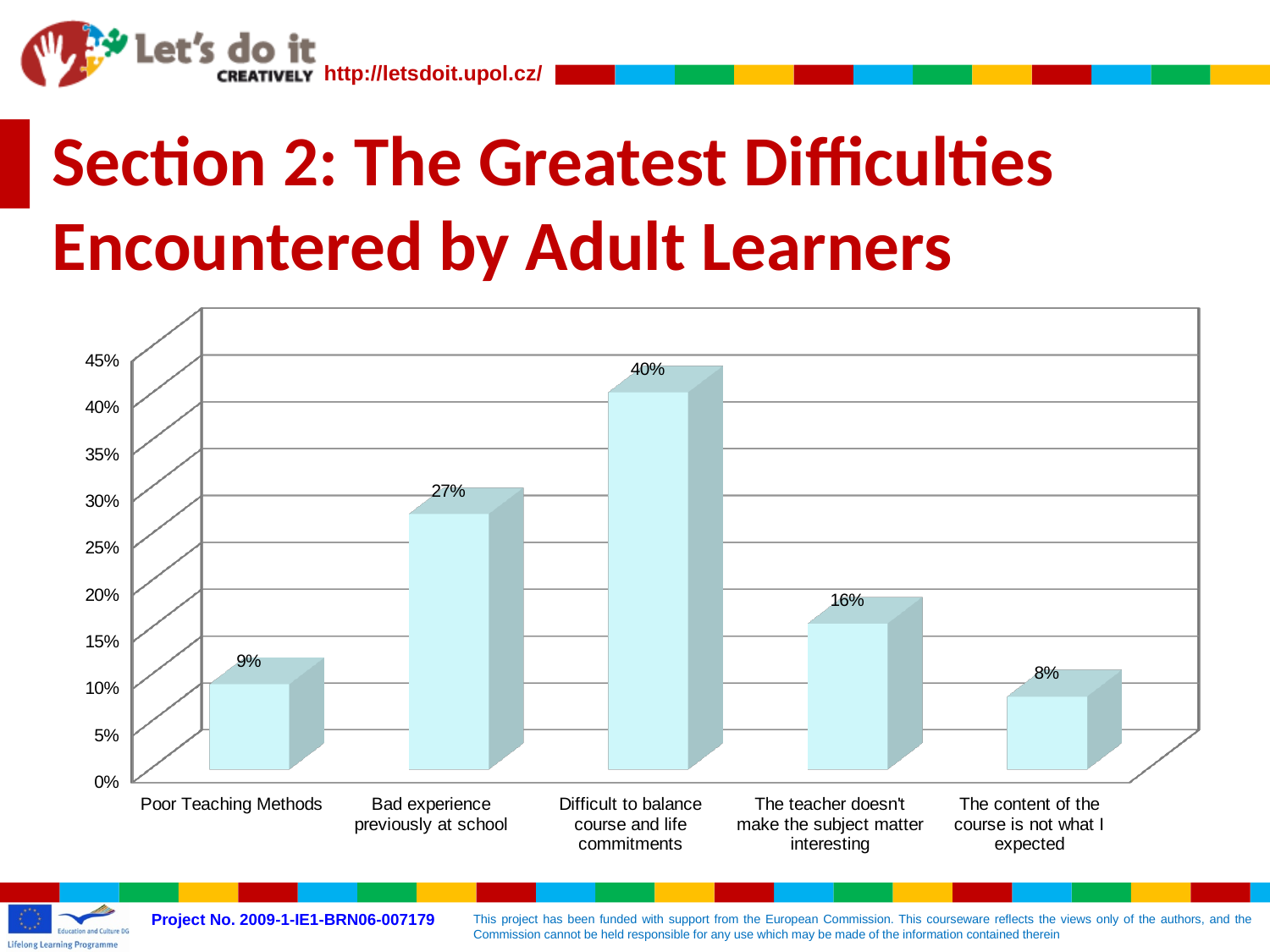
Which difficulty has the lowest percentage in the chart? The content of the course is not what I expected What is the value shown for "Bad experience previously at school"? 27% Is the value for "Bad experience previously at school" greater or less than 30%? less What is the highest value labelled on the vertical axis of the chart? 45% What percentage of adult learners cited "Poor Teaching Methods" as their greatest difficulty? 9% How many difficulty categories are shown in the chart? 5 What is the difference between the percentages for "Difficult to balance course and life commitments" and "Bad experience previously at school"? 13% Which difficulty has the highest percentage in the chart? Difficult to balance course and life commitments Which is larger: the value for "Poor Teaching Methods" or the value for "The teacher doesn't make the subject matter interesting"? The teacher doesn't make the subject matter interesting What is the value shown for "The teacher doesn't make the subject matter interesting"? 16% What kind of chart is shown on the slide? Bar chart What is the difference between the percentages for "The teacher doesn't make the subject matter interesting" and "The content of the course is not what I expected"? 8%